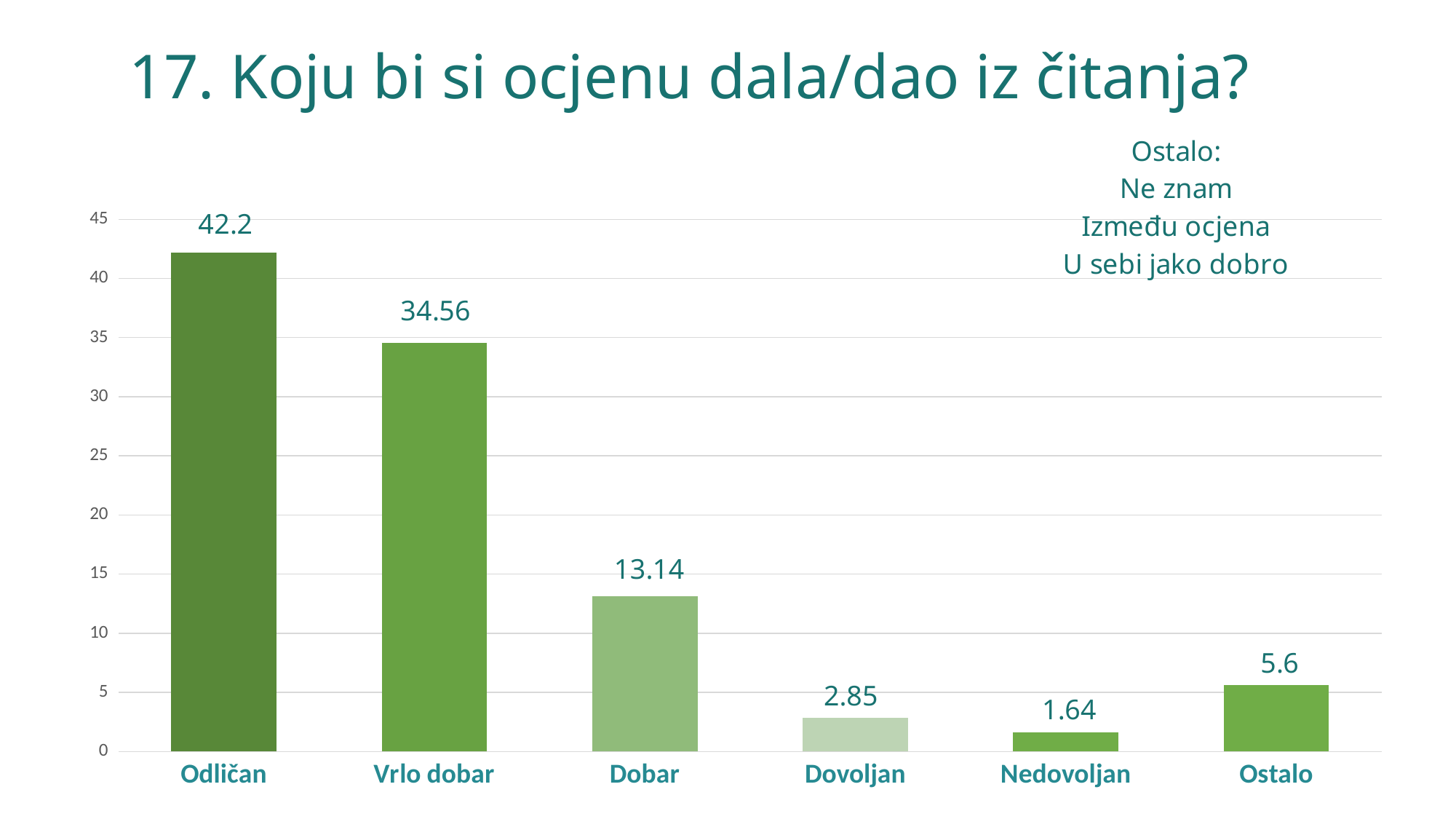
What is the value for Dobar? 13.14 What kind of chart is shown on the slide? bar chart Which is larger, the value for Ostalo or the value for Dovoljan? Ostalo Which category has the highest value? Odličan What is the difference between the values for Odličan and Vrlo dobar? 7.64 Is the value for Dobar greater or less than 15? less What is the value for Odličan? 42.2 What is the value for Nedovoljan? 1.64 How many categories are shown on the x axis? 6 What is the value for Vrlo dobar? 34.56 Which category has the lowest value? Nedovoljan What is the title of the slide? 17. Koju bi si ocjenu dala/dao iz čitanja?